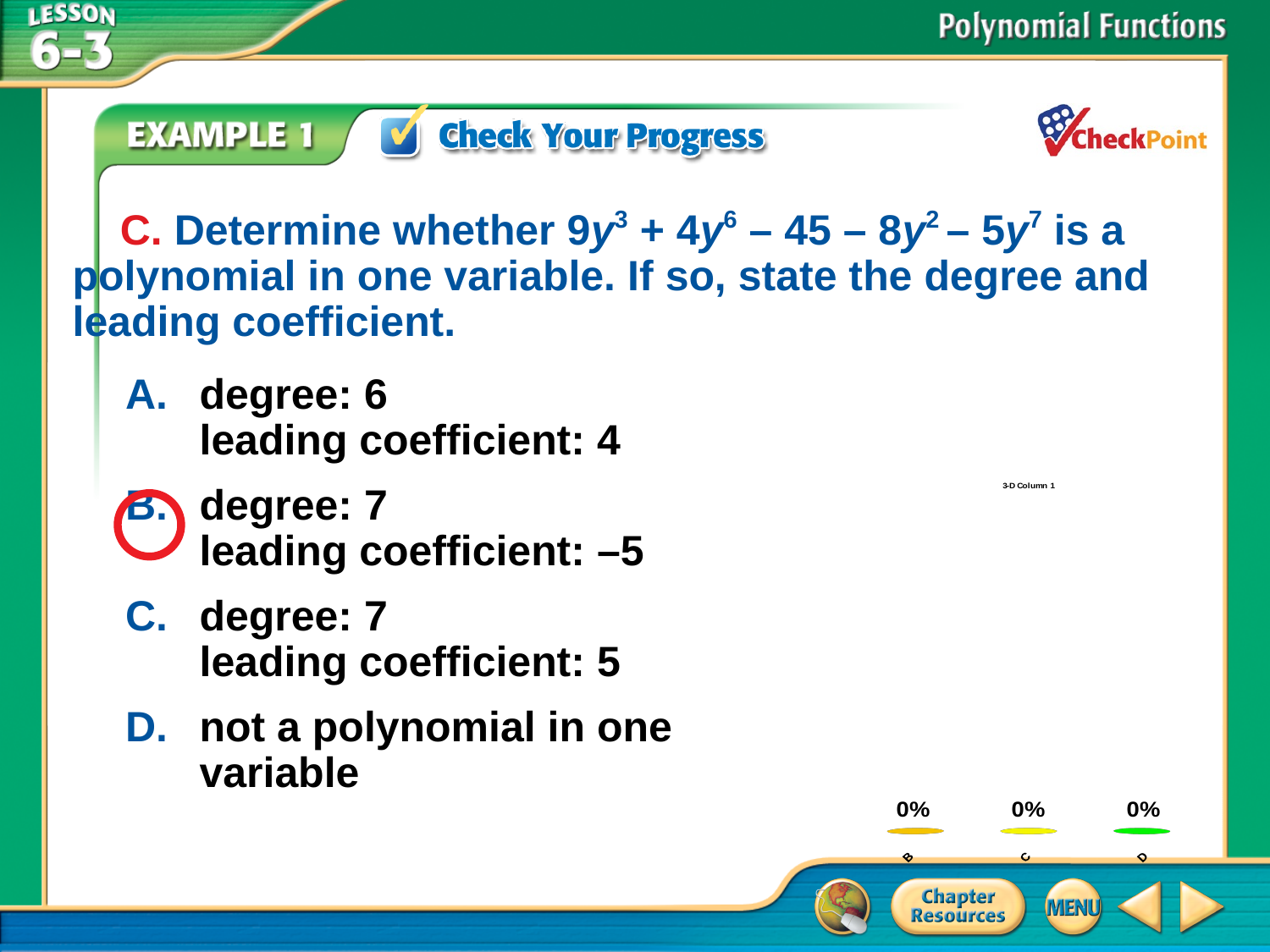
What kind of chart is shown at the bottom right of the slide? bar chart What is the value shown for category C in the chart at the bottom right of the slide? 0% What is the value shown for category B in the chart at the bottom right of the slide? 0% What is the value shown for category D in the chart at the bottom right of the slide? 0% What is the title printed above the chart at the bottom right of the slide? 3-D Column 1 What is the total of the values for B, C and D in the chart at the bottom right of the slide? 0% Do the values in the chart at the bottom right of the slide rise, fall, or stay the same from B to D? stay the same What is the difference between the values for B and D in the chart at the bottom right of the slide? 0%